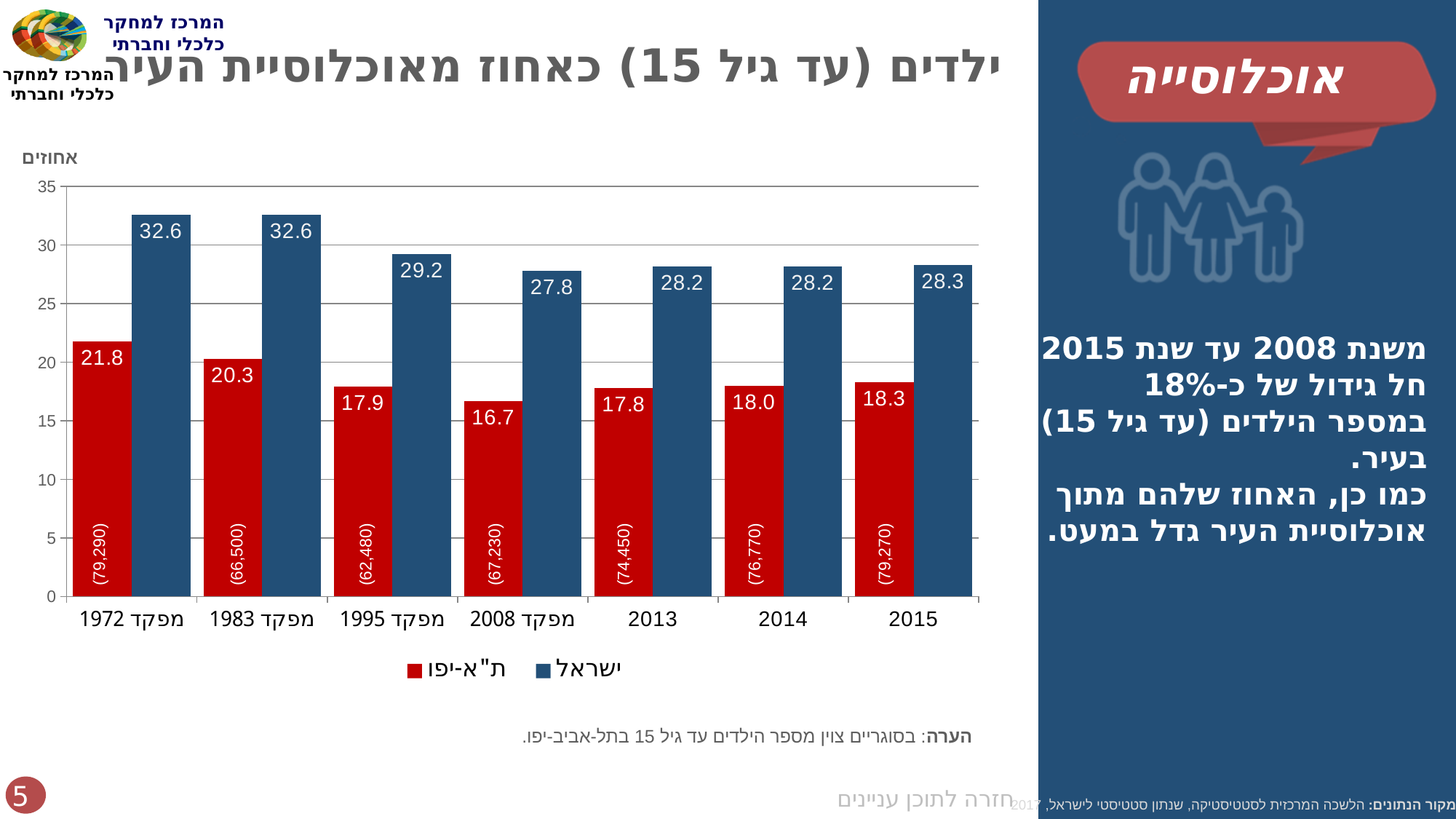
What is the value for ת"א-יפו in 2015? 18.3 How many categories are shown on the x axis? 7 Is the value for ישראל in 2013 greater or less than 25? greater How many series does the legend list? 2 What is the difference between the ישראל and ת"א-יפו values in מפקד 1972? 10.8 Which colour represents ת"א-יפו in the chart? red What kind of chart is shown on the slide? bar chart In which category is the ת"א-יפו value highest? מפקד 1972 What is the value for ישראל in מפקד 1995? 29.2 What number of children is shown in parentheses on the ת"א-יפו bar for מפקד 2008? (67,230) Which is larger in 2014: the value for ישראל or for ת"א-יפו? ישראל In which category is the ת"א-יפו value lowest? מפקד 2008